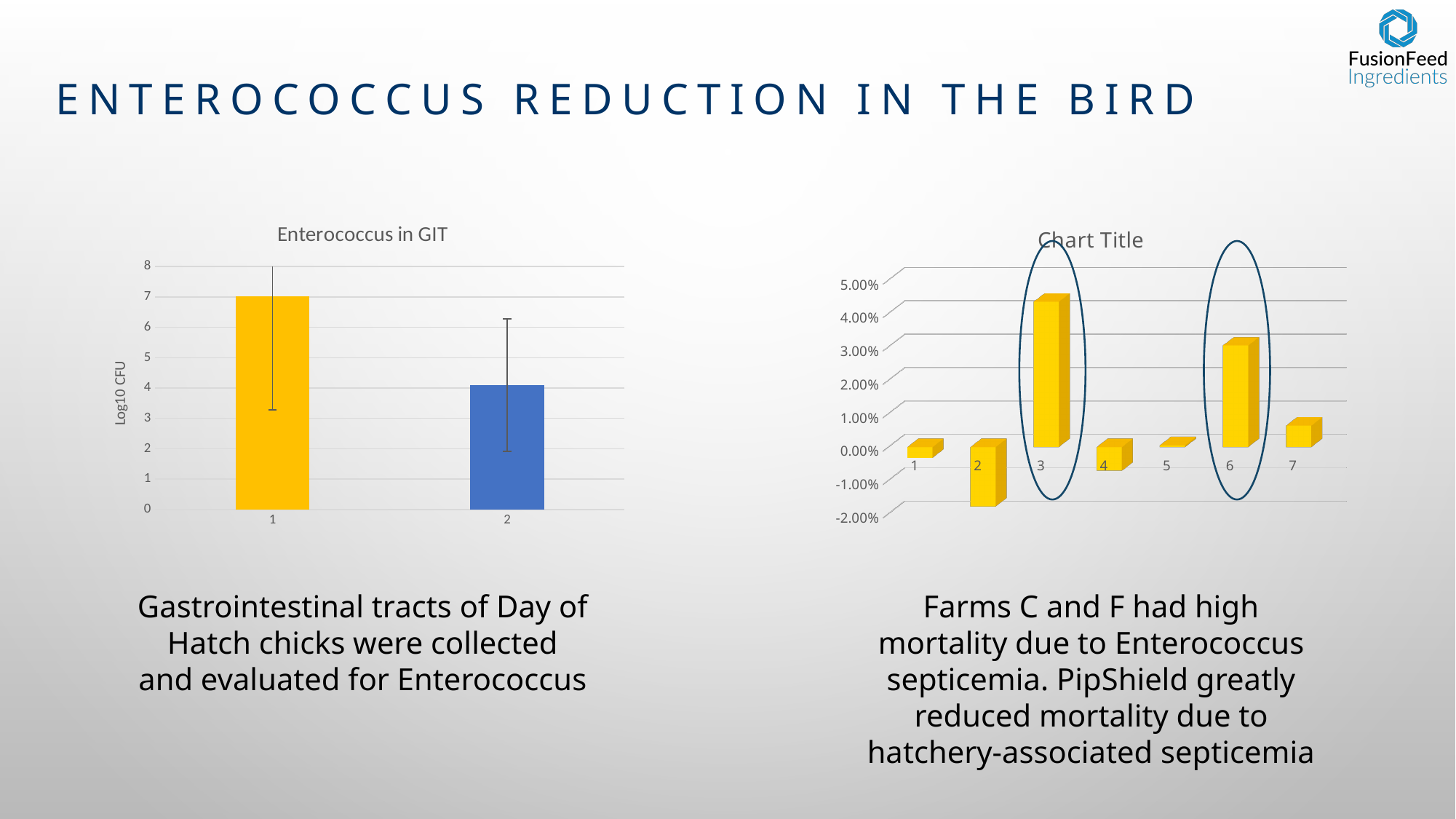
How many bars are plotted in the 'Enterococcus in GIT' chart? 2 In the chart on the right titled 'Chart Title', which category has the highest value? 3 What is the y-axis label of the 'Enterococcus in GIT' chart? Log10 CFU In the 'Enterococcus in GIT' chart, is the value for category 2 greater or less than 5? less In the 'Enterococcus in GIT' chart, which category has the highest value? 1 In the chart on the right titled 'Chart Title', is the value for category 3 greater or less than 4.00%? greater In the chart on the right titled 'Chart Title', which category has the lowest value? 2 In the 'Enterococcus in GIT' chart, which is larger, the value for category 1 or category 2? 1 How many categories are plotted in the chart on the right titled 'Chart Title'? 7 In the chart on the right titled 'Chart Title', is the value for category 2 greater or less than -1.00%? less What type of chart is the 'Enterococcus in GIT' chart on the left? bar chart